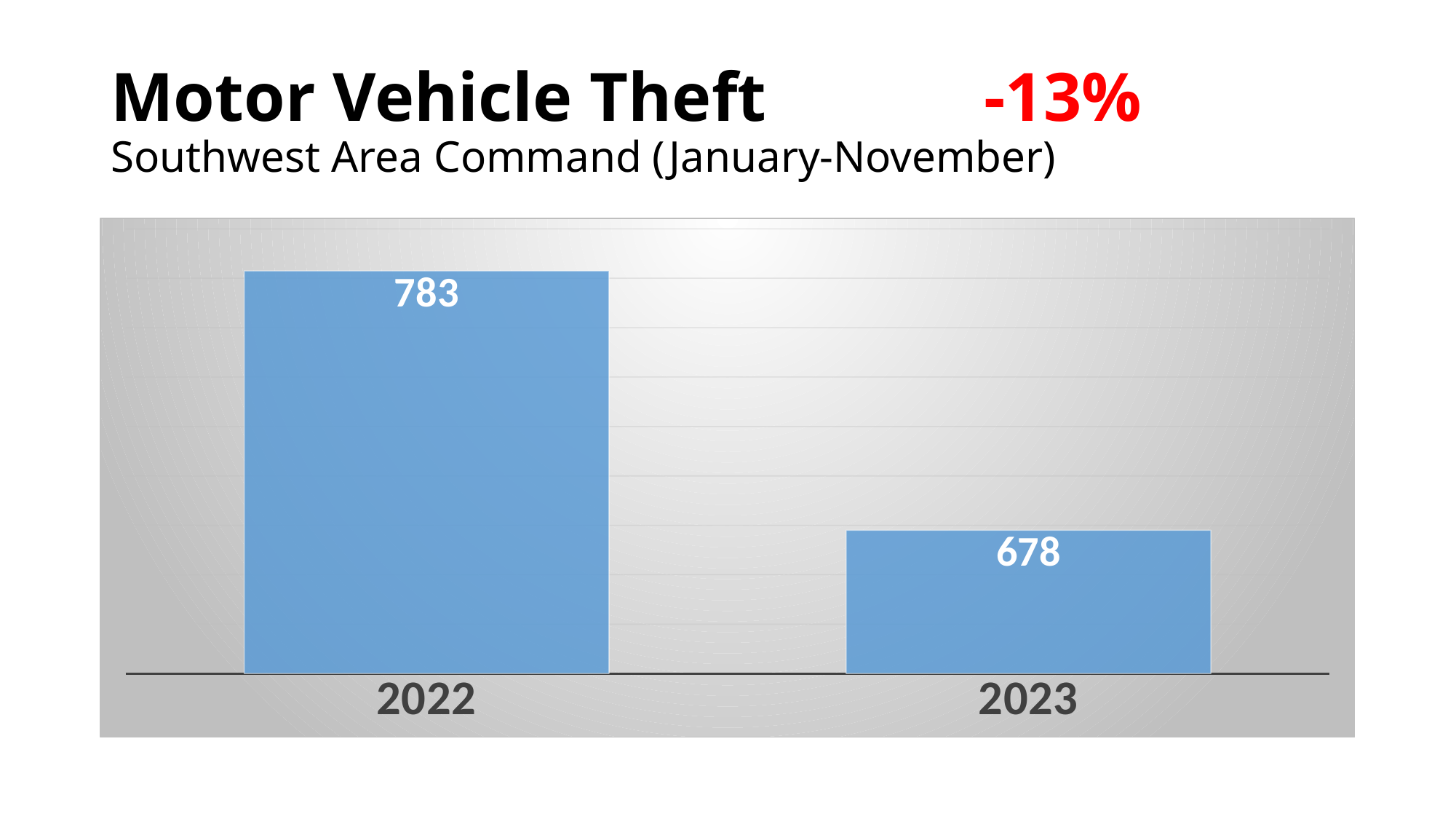
Which year has the lowest value? 2023 What is the value for 2023? 678 Which year has the highest value? 2022 What is the difference between the 2022 and 2023 values? 105 What is the title of the chart? Motor Vehicle Theft What percentage change is shown in red next to the title? -13% How many categories are shown on the x axis? 2 Do the values rise or fall from 2022 to 2023? fall Which is larger, the value for 2022 or the value for 2023? 2022 What kind of chart is shown on the slide? bar chart What is the value for 2022? 783